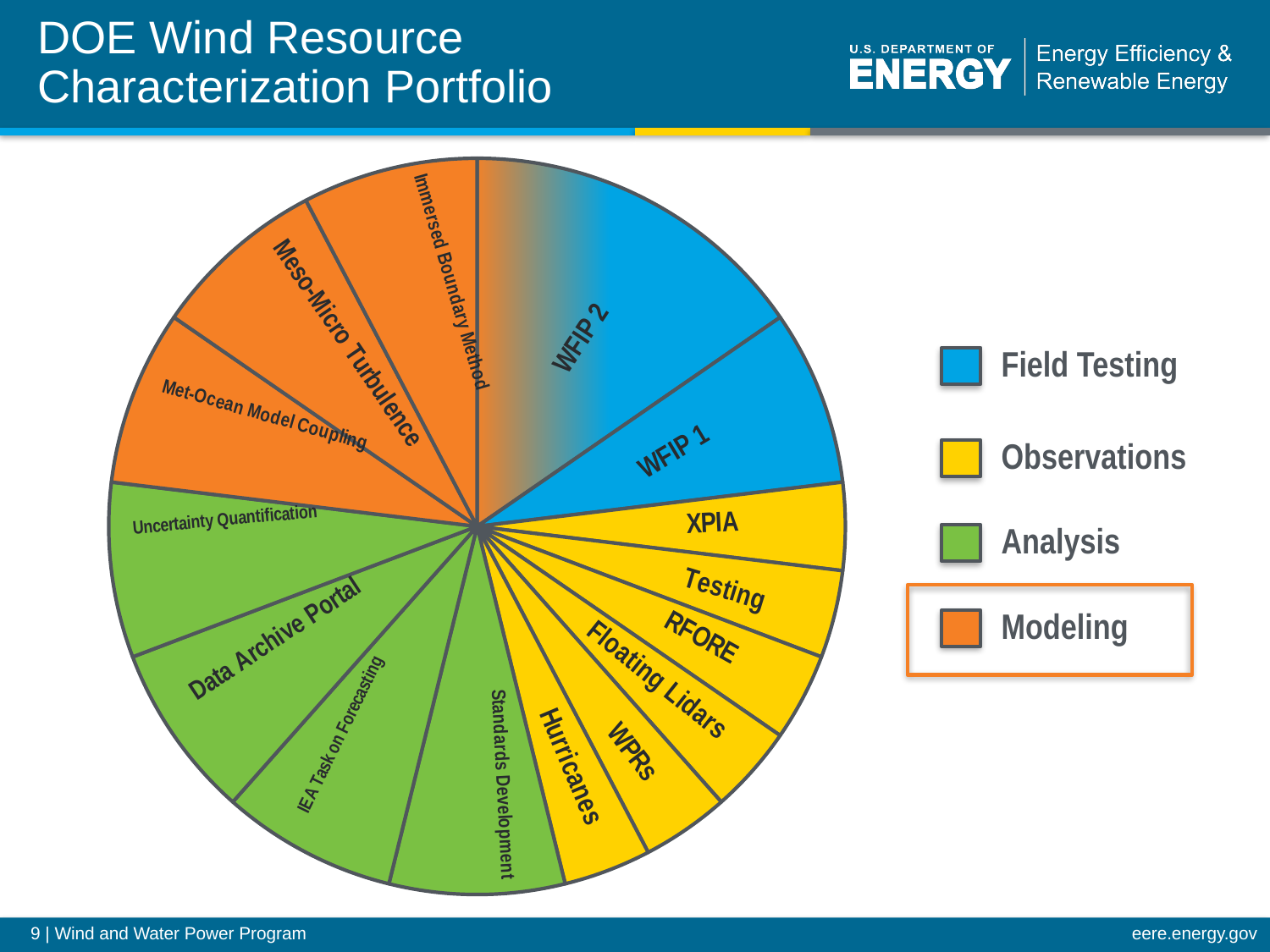
How many slices does the pie chart have? 15 Which slice is larger, Standards Development or XPIA? Standards Development Which slice is larger, Data Archive Portal or Hurricanes? Data Archive Portal How many slices are coloured green (Analysis)? 4 Which slice is larger, Meso-Micro Turbulence or RFORE? Meso-Micro Turbulence How many entries does the legend list? 4 How many slices are coloured blue (Field Testing)? 2 According to the legend colours, which category does the WFIP 1 slice belong to? Field Testing What kind of chart is shown on the slide? pie chart Which legend entry is highlighted with an orange box? Modeling